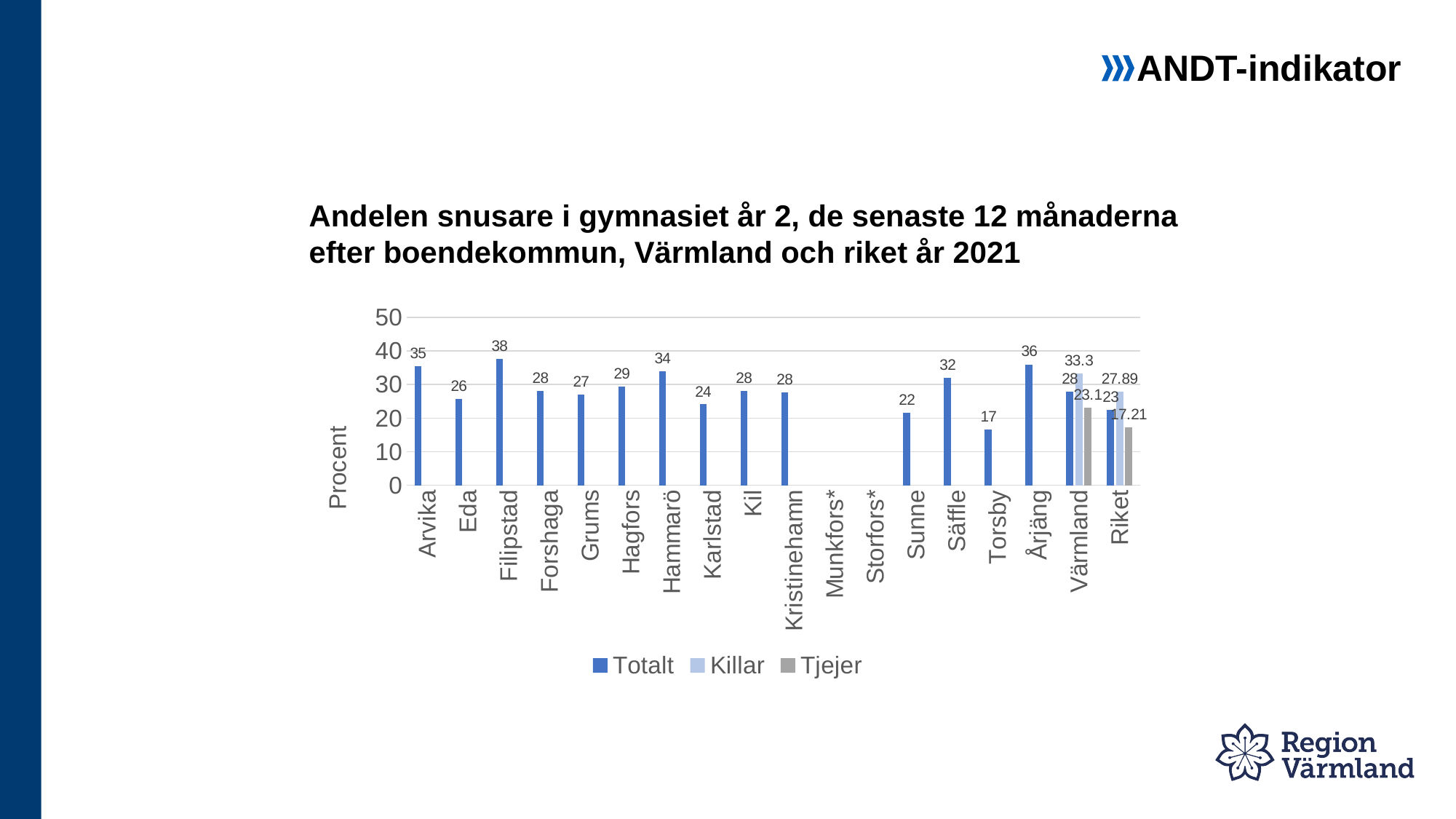
Which has a higher Totalt value, Hammarö or Säffle? Hammarö What is the Killar value for Riket? 27.89 What is the label on the y axis? Procent How many categories are shown on the x axis? 18 Which category has the highest Totalt value? Filipstad What is the Tjejer value for Värmland? 23.1 How many series does the legend list? 3 What is the difference between the Totalt values for Arvika and Eda? 9 What is the Totalt value for Filipstad? 38 What kind of chart is shown on the slide? Bar chart What is the difference between the Killar and Tjejer values for Värmland? 10.2 Which category has the lowest Totalt value among those with a plotted bar? Torsby